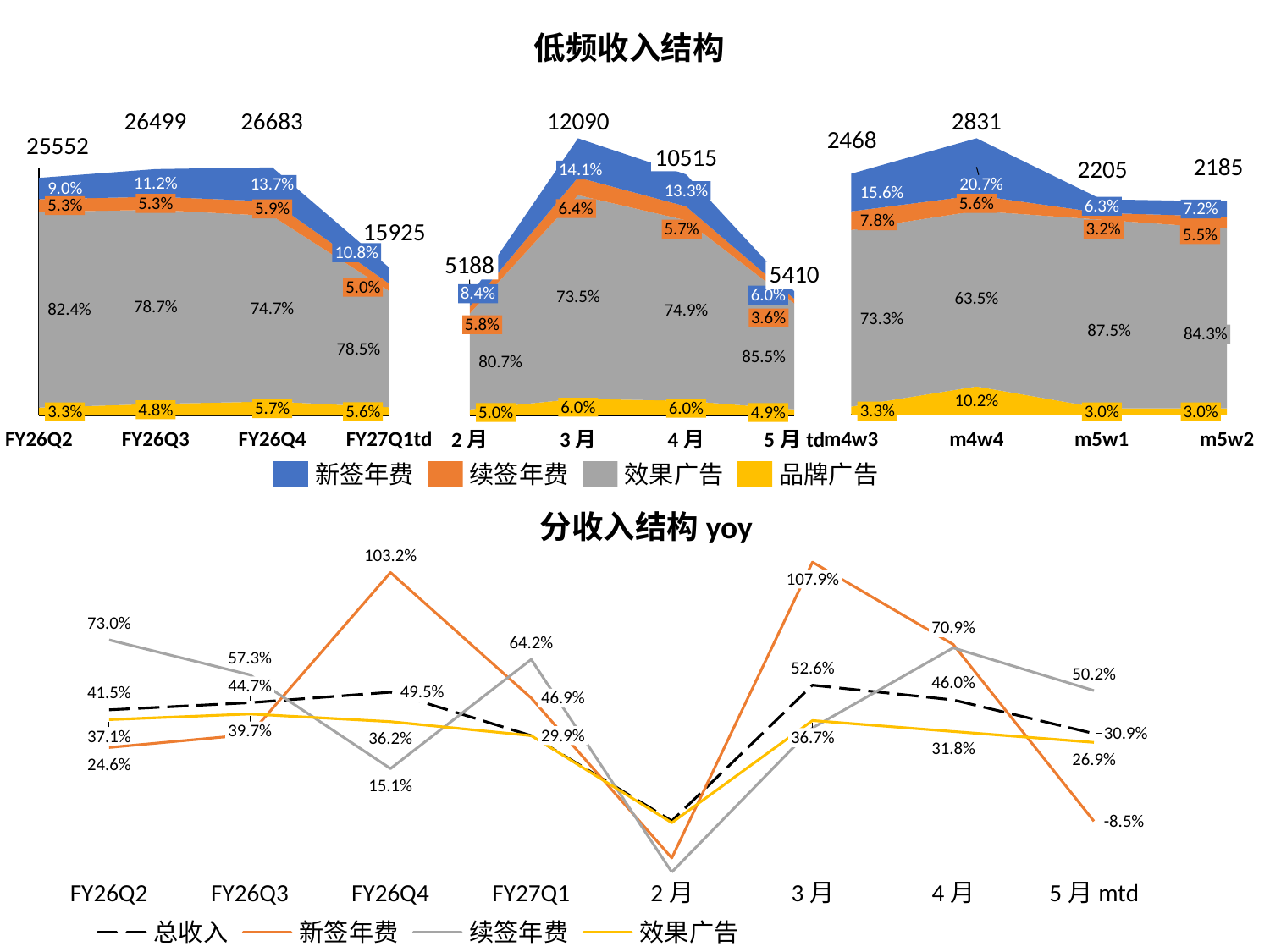
In the top chart 低频收入结构, what is the total value shown above FY26Q4? 26683 In the bottom chart 分收入结构 yoy, what is the value of 新签年费 at 5月 mtd? -8.5% In the top chart 低频收入结构, what share does 新签年费 have in 3月? 14.1% How many categories are shown on the x axis of the bottom chart 分收入结构 yoy? 8 In the top chart 低频收入结构, what share does 效果广告 have in FY26Q2? 82.4% In the bottom chart 分收入结构 yoy, what is the value of 续签年费 at FY26Q4? 15.1% In the bottom chart 分收入结构 yoy, what is the value of 新签年费 at FY26Q4? 103.2% In the top chart 低频收入结构, what share does 品牌广告 have in m4w4? 10.2% In the top chart 低频收入结构, which of the months 2月, 3月, 4月 and 5月td has the highest total value? 3月 In the top chart 低频收入结构, which of the weeks m4w3, m4w4, m5w1 and m5w2 has the lowest total value? m5w2 In the bottom chart 分收入结构 yoy, what is the difference between 新签年费 at 3月 (107.9%) and at 4月 (70.9%)? 37.0% How many series does the legend of the top chart 低频收入结构 list? 4